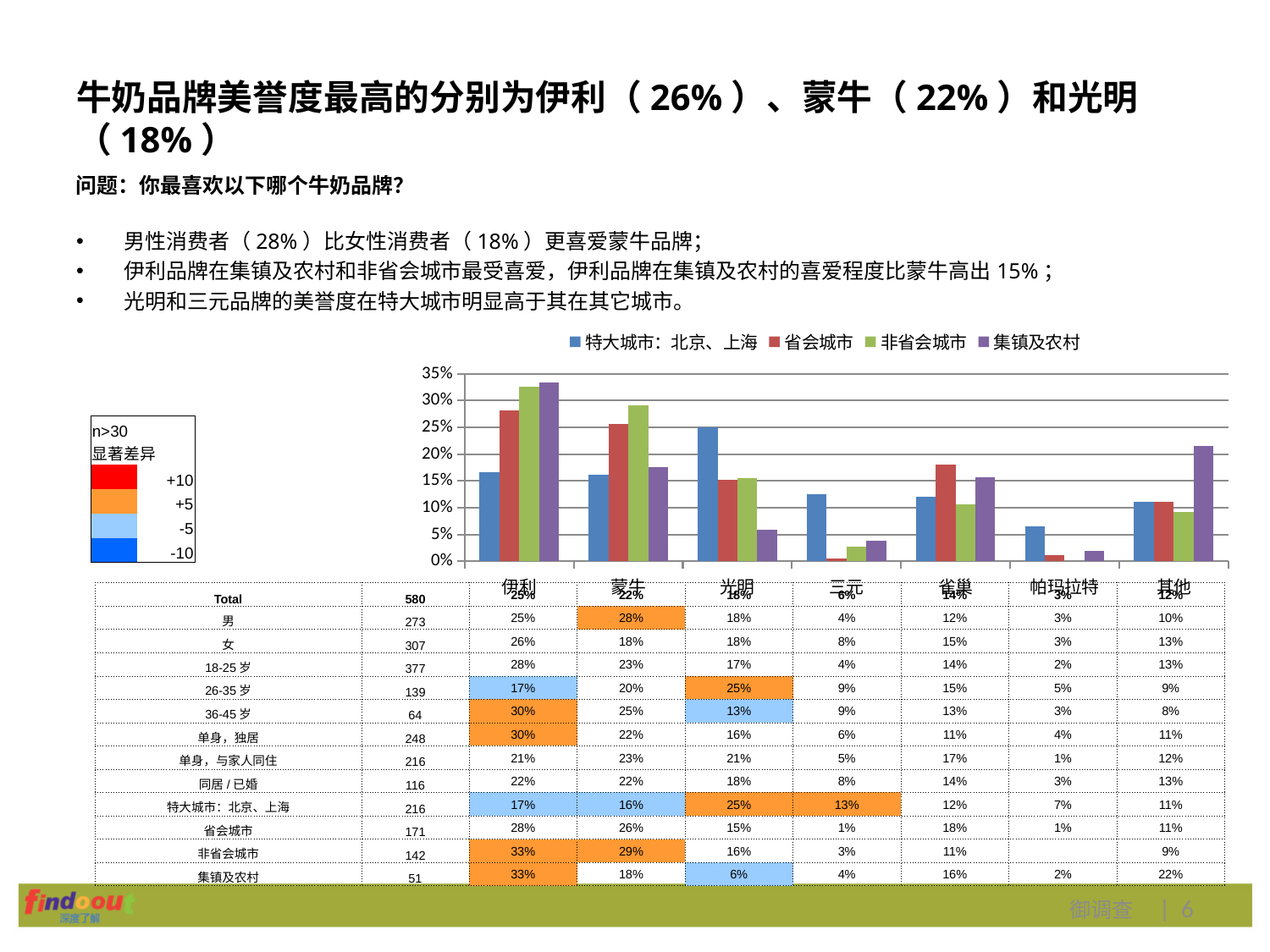
Is the value for 非省会城市 in the 伊利 category greater or less than 30%? greater Which brand category has the highest 集镇及农村 bar? 伊利 Which brand category has the lowest 特大城市：北京、上海 bar? 帕玛拉特 In the 蒙牛 category, which is larger: the 省会城市 bar or the 集镇及农村 bar? 省会城市 Is the value for 特大城市：北京、上海 in the 光明 category greater or less than 20%? greater How many brand categories are shown along the x axis of the chart? 7 Is the value for 省会城市 in the 雀巢 category greater or less than 15%? greater What is the first entry in the chart legend? 特大城市：北京、上海 In the 光明 category, which series has the tallest bar? 特大城市：北京、上海 How many series does the chart legend list? 4 What kind of chart is shown on the slide? bar chart